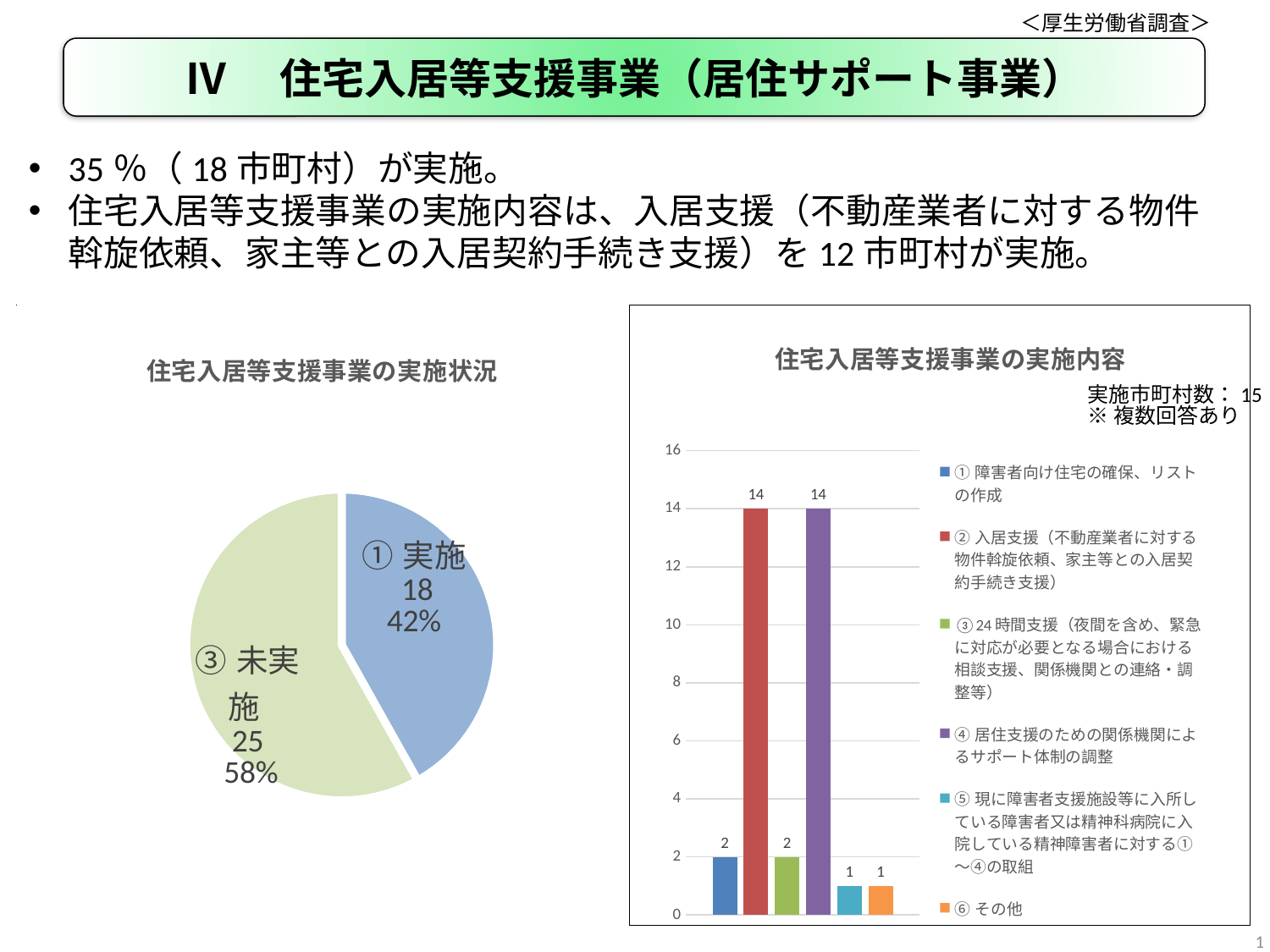
In the pie chart titled 住宅入居等支援事業の実施状況, which slice is larger, ① 実施 or ③ 未実施? ③ 未実施 In the bar chart titled 住宅入居等支援事業の実施内容, is the value for ② greater or less than 10? greater In the bar chart titled 住宅入居等支援事業の実施内容, what is the value for ② 入居支援? 14 In the pie chart titled 住宅入居等支援事業の実施状況, what is the difference between the values for ③ 未実施 and ① 実施? 7 In the bar chart titled 住宅入居等支援事業の実施内容, how many series does the legend list? 6 In the bar chart titled 住宅入居等支援事業の実施内容, what is the difference between the values for ④ and ③? 12 In the bar chart titled 住宅入居等支援事業の実施内容, which series has the lowest value? ⑤ and ⑥ (both 1) What kind of chart is the one titled 住宅入居等支援事業の実施内容? bar chart In the pie chart titled 住宅入居等支援事業の実施状況, what is the value for ① 実施? 18 What kind of chart is the one titled 住宅入居等支援事業の実施状況? pie chart In the pie chart titled 住宅入居等支援事業の実施状況, what percentage share does ③ 未実施 have? 58% In the bar chart titled 住宅入居等支援事業の実施内容, what is the value for ⑤? 1